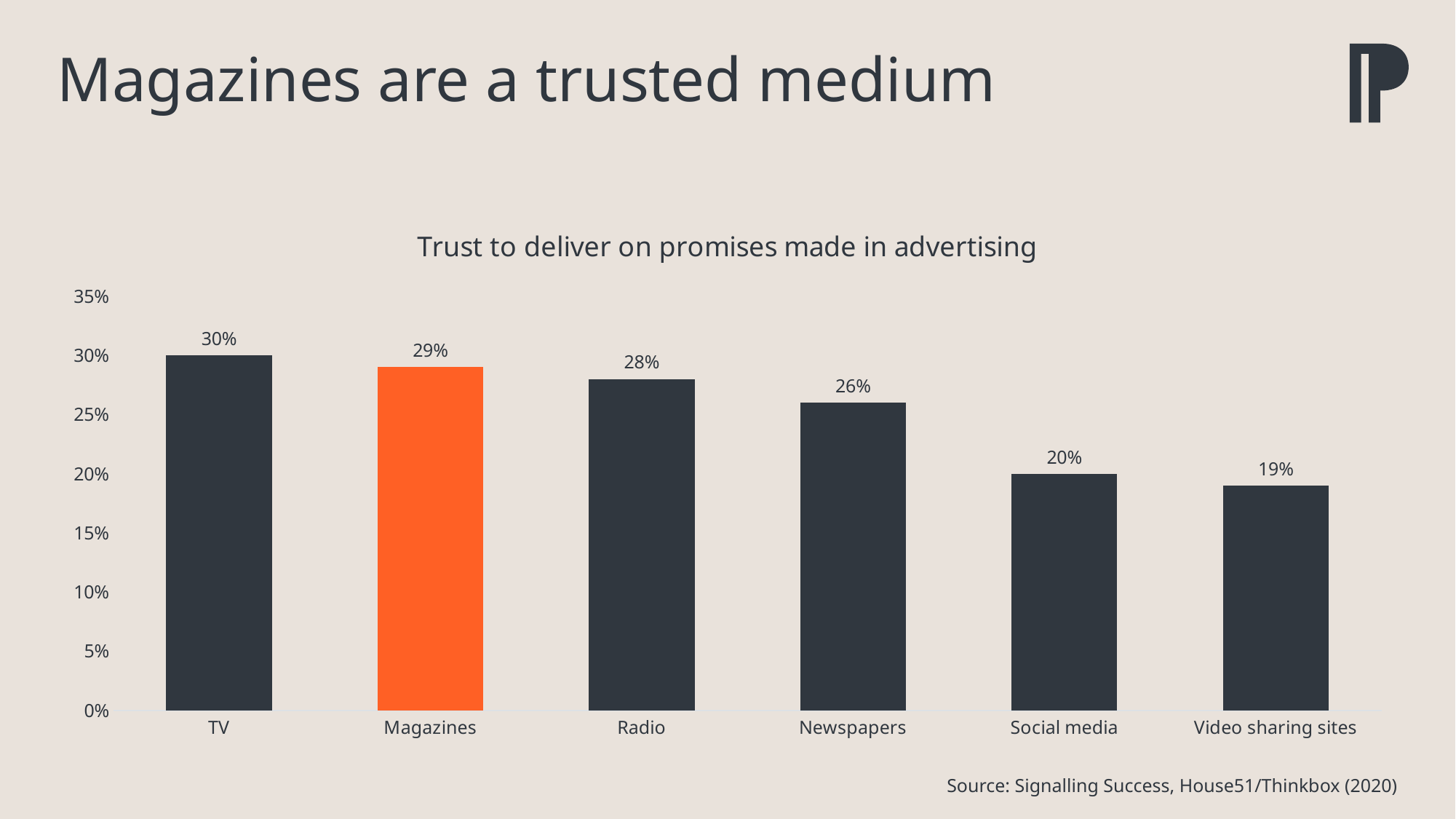
What is the difference between the values for TV and Newspapers? 4% Which category has the highest value? TV What kind of chart is shown on the slide? Bar chart Which category has the lowest value? Video sharing sites What is the value for Magazines? 29% Is the value for Radio greater or less than 25%? greater How many categories are shown on the x axis? 6 What is the difference between the values for Radio and Social media? 8% Which is larger, the value for Newspapers or the value for Social media? Newspapers What is the value for Social media? 20% What is the value for Video sharing sites? 19% What is the title of the chart? Trust to deliver on promises made in advertising